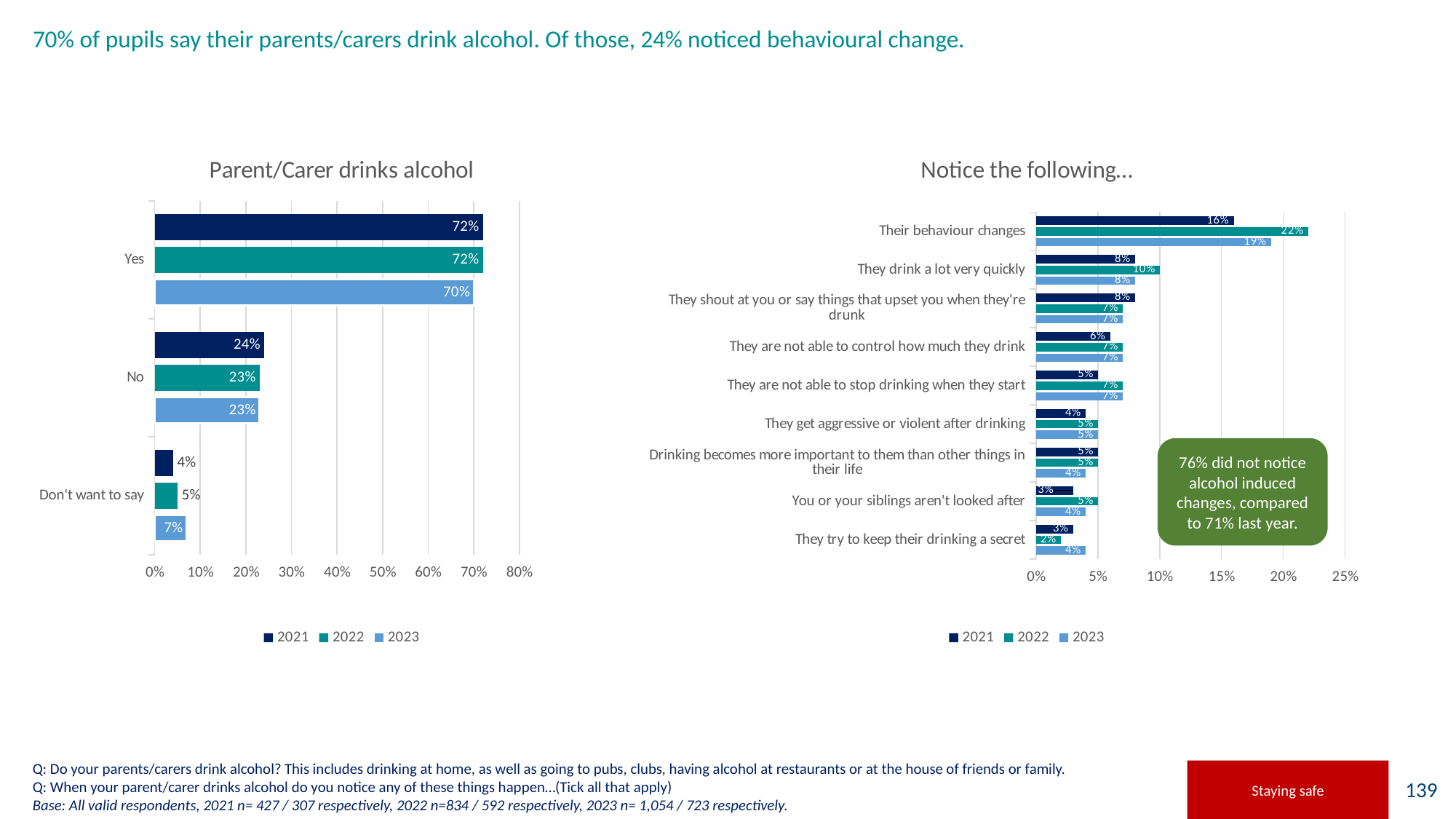
In the 'Notice the following...' chart, what is the 2023 value for 'They drink a lot very quickly'? 8% In the 'Notice the following...' chart, how many categories are shown? 9 In the 'Parent/Carer drinks alcohol' chart, how many series does the legend list? 3 In the 'Parent/Carer drinks alcohol' chart, what is the 2023 value for 'Don't want to say'? 7% In the 'Notice the following...' chart, which category has the highest 2023 value? Their behaviour changes In the 'Notice the following...' chart, which is larger for 'Their behaviour changes': the 2021 value or the 2022 value? 2022 In the 'Parent/Carer drinks alcohol' chart, what is the 2023 value for 'Yes'? 70% What kind of chart is 'Notice the following...'? Bar chart In the 'Parent/Carer drinks alcohol' chart, what is the difference between the 2021 and 2023 values for 'Don't want to say'? 3% In the 'Notice the following...' chart, what is the 2022 value for 'Their behaviour changes'? 22% In the 'Notice the following...' chart, what is the difference between the 2022 and 2023 values for 'Their behaviour changes'? 3% In the 'Parent/Carer drinks alcohol' chart, what is the 2021 value for 'No'? 24%